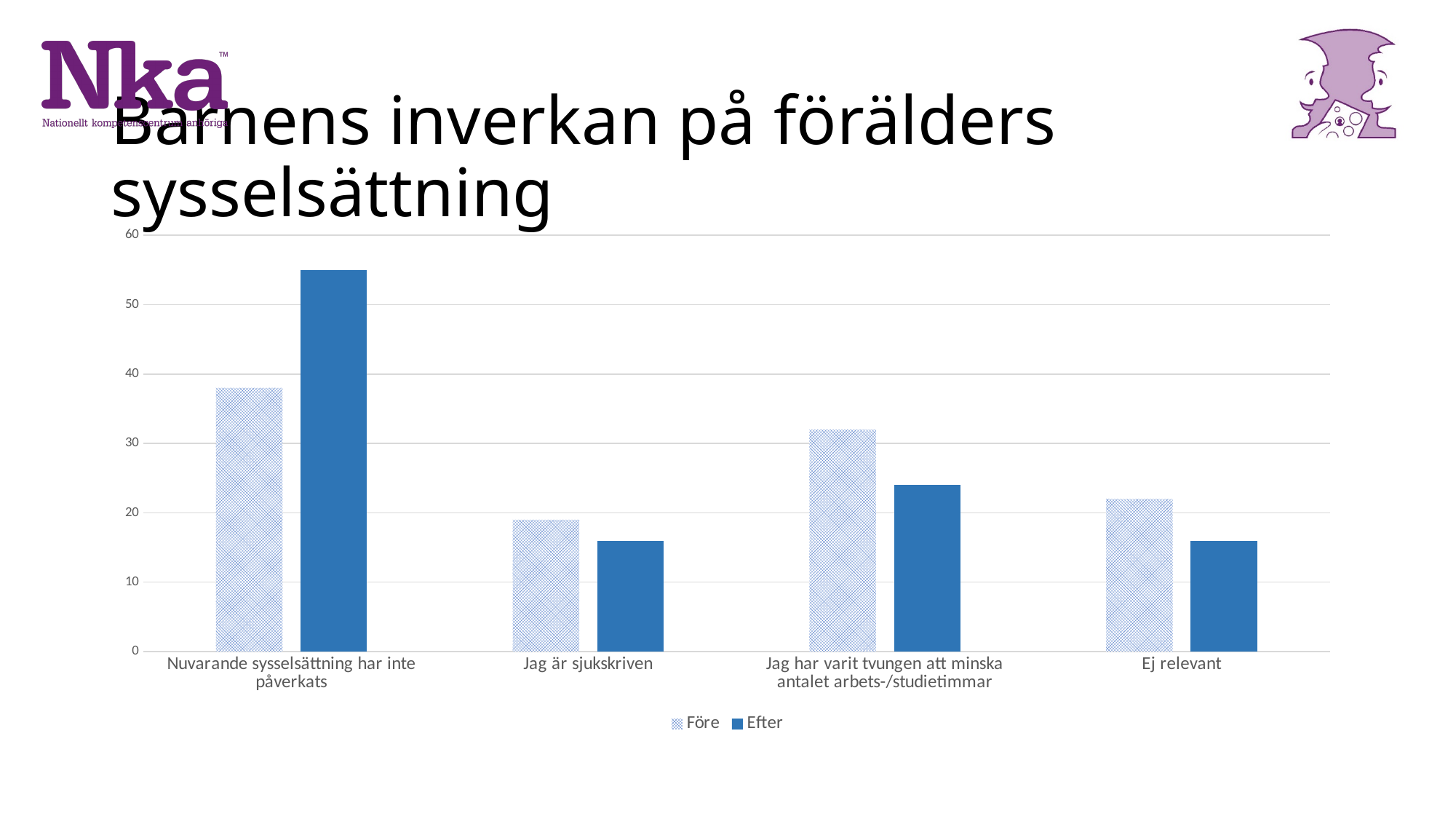
For Nuvarande sysselsättning har inte påverkats, which is larger, the Före value or the Efter value? Efter Which category has the highest Efter value? Nuvarande sysselsättning har inte påverkats Is the Före value for Jag har varit tvungen att minska antalet arbets-/studietimmar greater or less than 30? greater Which category has the lowest Före value? Jag är sjukskriven Is the Efter value for Nuvarande sysselsättning har inte påverkats greater or less than 50? greater How many series does the legend list? 2 Is the Före value for Ej relevant greater or less than 20? greater What kind of chart is shown on the slide? bar chart For Jag har varit tvungen att minska antalet arbets-/studietimmar, which is larger, the Före value or the Efter value? Före What are the two series named in the legend? Före and Efter How many categories are shown on the x axis of the chart? 4